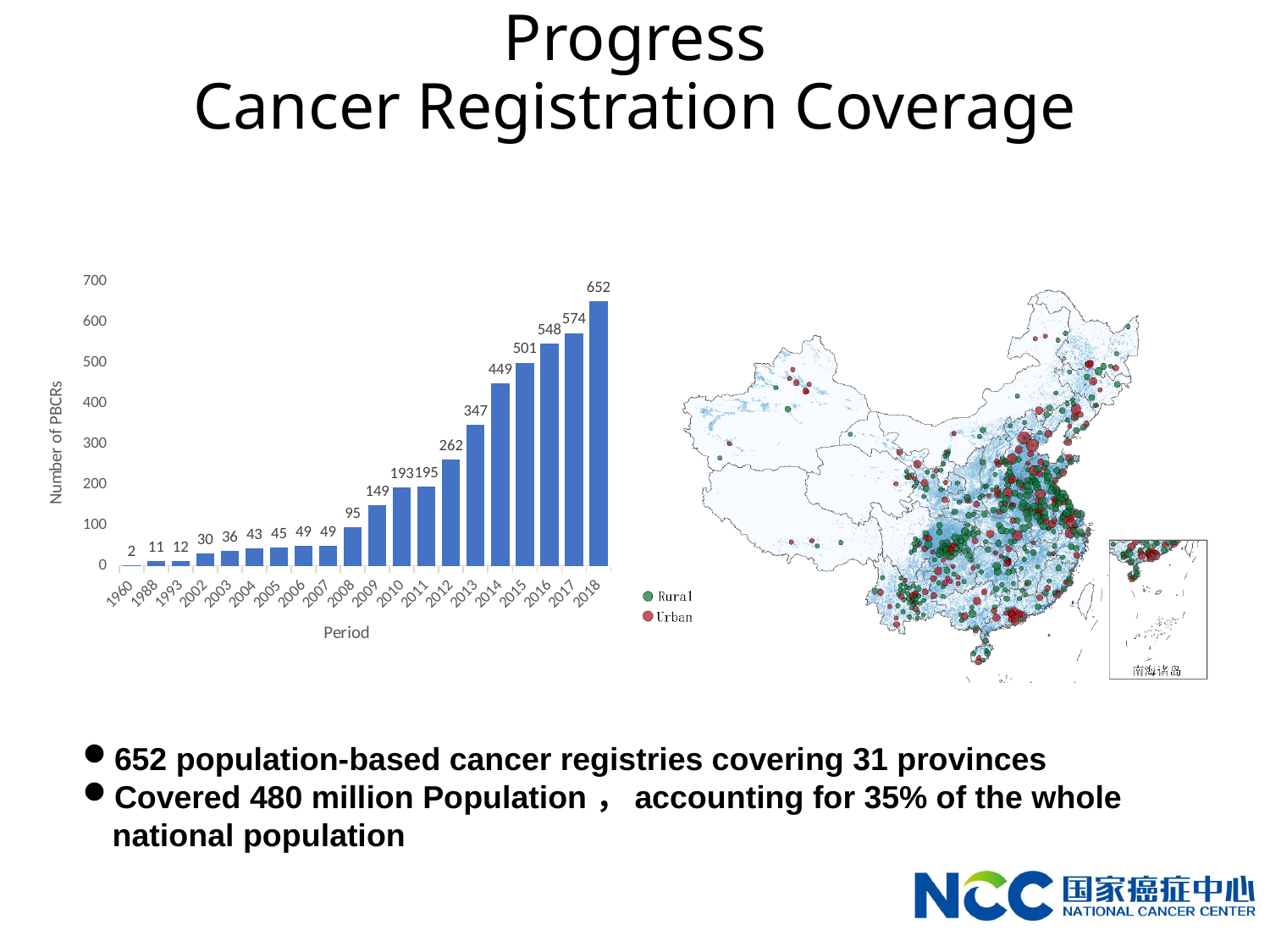
What is the difference in the number of PBCRs between 2018 and 2017? 78 What is the label of the y axis of the bar chart? Number of PBCRs How many periods are shown on the x axis of the bar chart? 20 What is the difference in the number of PBCRs between 2014 and 2013? 102 What is the number of PBCRs in 2013? 347 What is the number of PBCRs in 2018? 652 What type of chart is used to show the number of PBCRs by period? bar chart What is the number of PBCRs in 2008? 95 Which period has the highest number of PBCRs? 2018 Which period has more PBCRs, 2012 or 2015? 2015 Which period has the lowest number of PBCRs? 1960 Does the number of PBCRs generally rise or fall from 1960 to 2018? rise